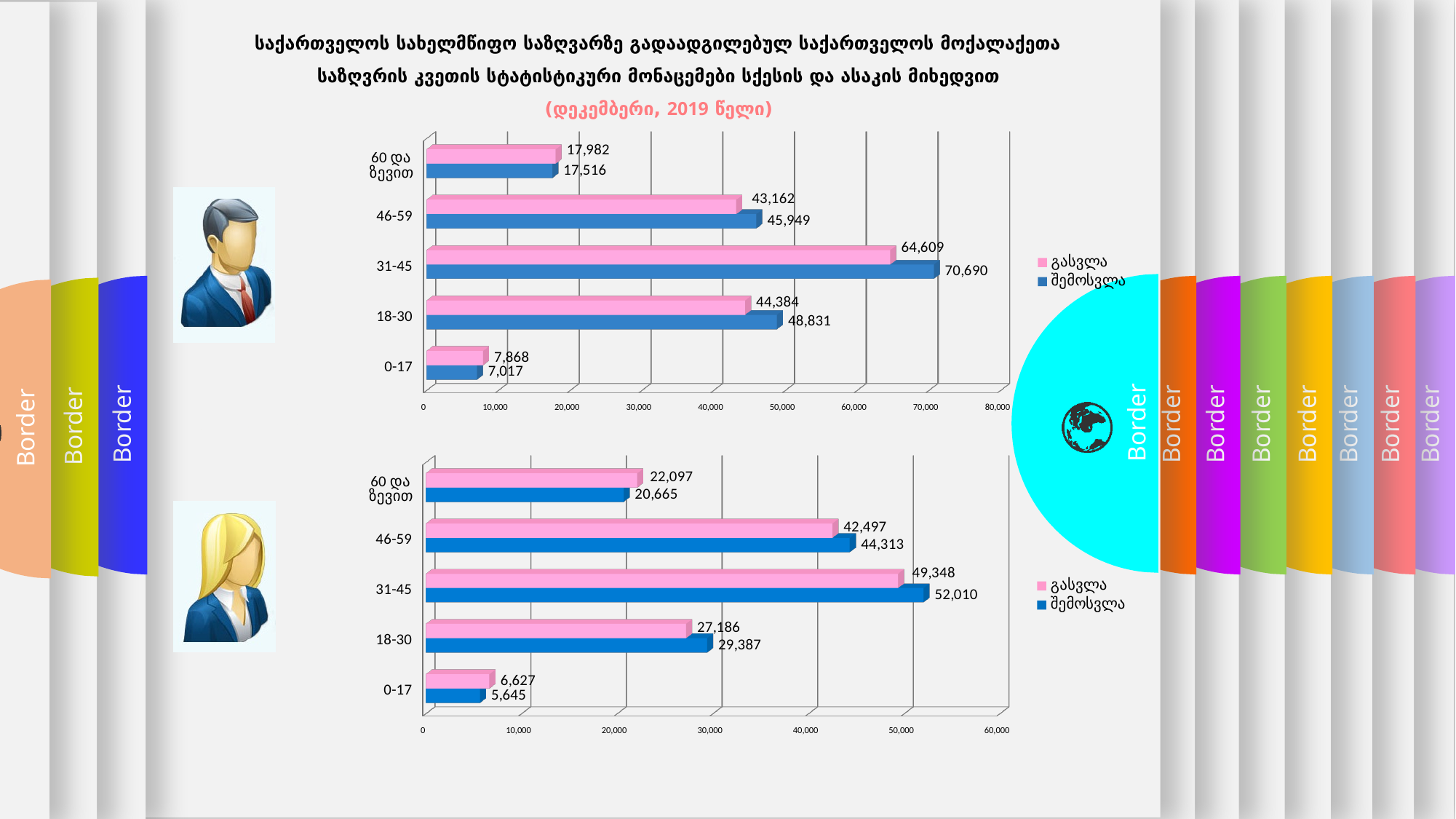
In the bottom chart, what is the გასვლა value for the 60 და ზევით age group? 22,097 What type of chart is the bottom chart? Bar chart How many age groups are shown in the bottom chart? 5 In the top chart, what is the გასვლა value for the 0-17 age group? 7,868 In the top chart, what is the difference between the შემოსვლა and გასვლა values for the 31-45 age group? 6,081 In the top chart, which is larger for the 46-59 age group: გასვლა or შემოსვლა? შემოსვლა In the bottom chart, what is the შემოსვლა value for the 18-30 age group? 29,387 In the top chart, which age group has the highest შემოსვლა value? 31-45 How many series does the legend of the top chart list? 2 In the bottom chart, what is the difference between the შემოსვლა and გასვლა values for the 46-59 age group? 1,816 In the bottom chart, which age group has the lowest გასვლა value? 0-17 In the top chart, what is the შემოსვლა value for the 31-45 age group? 70,690